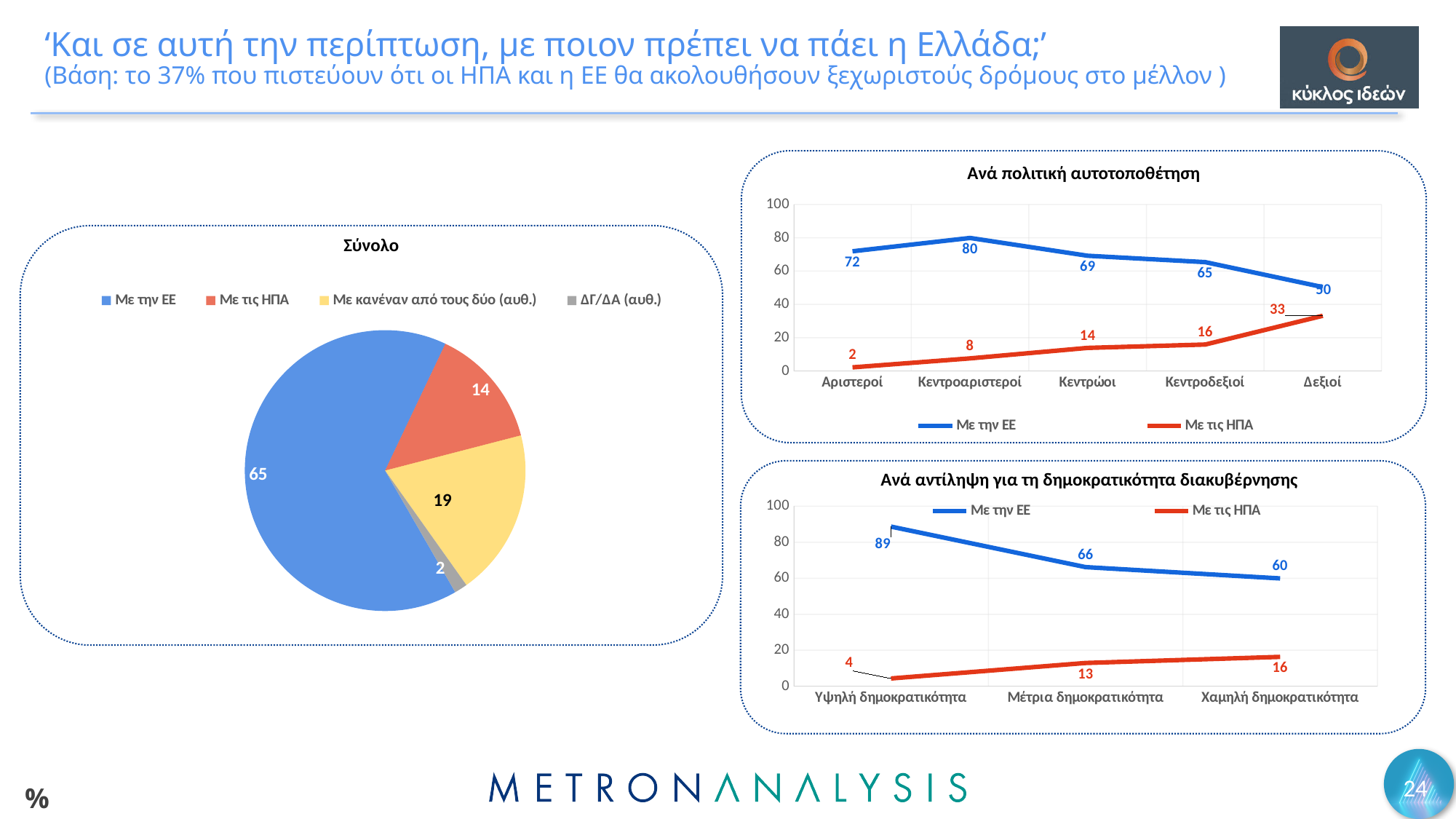
How many series does the legend of the 'Ανά αντίληψη για τη δημοκρατικότητα διακυβέρνησης' chart list? 2 In the 'Σύνολο' pie chart, which category has the smallest slice? ΔΓ/ΔΑ (αυθ.) In the 'Ανά αντίληψη για τη δημοκρατικότητα διακυβέρνησης' chart, what is the difference between 'Με την ΕΕ' and 'Με τις ΗΠΑ' for 'Χαμηλή δημοκρατικότητα'? 44 In the 'Ανά πολιτική αυτοτοποθέτηση' chart, what is the value of 'Με την ΕΕ' for 'Κεντροαριστεροί'? 80 In the 'Σύνολο' pie chart, what is the value for 'Με κανέναν από τους δύο (αυθ.)'? 19 In the 'Ανά πολιτική αυτοτοποθέτηση' chart, does the 'Με τις ΗΠΑ' series rise or fall from 'Αριστεροί' to 'Δεξιοί'? Rise What type of chart is the 'Σύνολο' chart? Pie chart In the 'Ανά αντίληψη για τη δημοκρατικότητα διακυβέρνησης' chart, what is the value of 'Με την ΕΕ' for 'Υψηλή δημοκρατικότητα'? 89 In the 'Ανά πολιτική αυτοτοποθέτηση' chart, how many categories are shown on the x axis? 5 In the 'Σύνολο' pie chart, what is the difference between 'Με την ΕΕ' and 'Με τις ΗΠΑ'? 51 In the 'Σύνολο' pie chart, what is the value for 'Με την ΕΕ'? 65 In the 'Ανά πολιτική αυτοτοποθέτηση' chart, what is the value of 'Με τις ΗΠΑ' for 'Δεξιοί'? 33